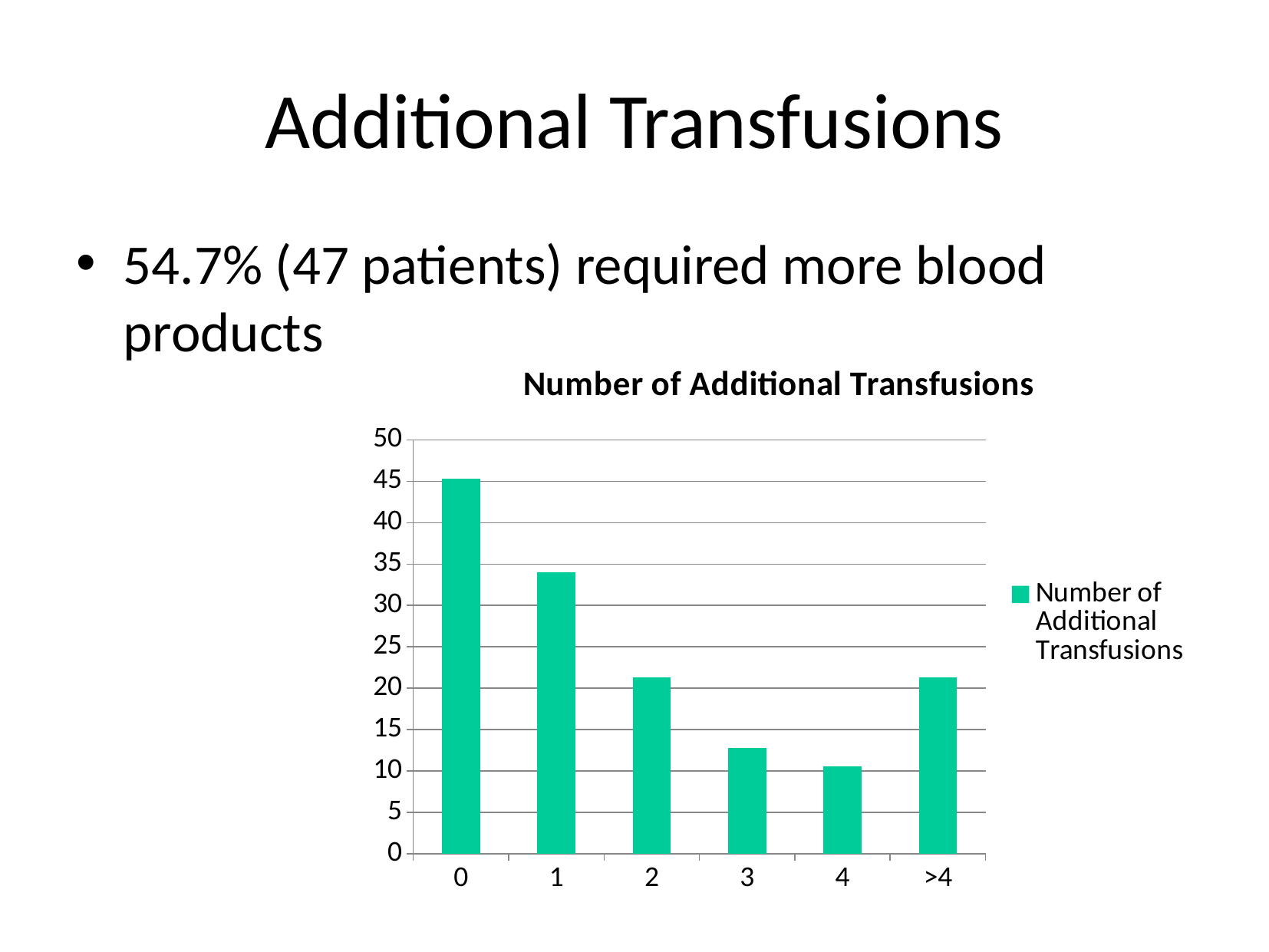
Is the value for category 1 greater or less than 30? greater Which category has the highest bar? 0 What type of chart is shown on the slide? bar chart How many categories are shown on the x axis of the chart? 6 Is the value for category 0 greater or less than 40? greater Is the value for category 3 greater or less than 15? less Which is larger, the value for category 1 or the value for category 3? 1 How many series does the legend list? 1 Which category has the lowest bar? 4 Do the values rise or fall from category 0 to category 4? fall What is the title of the chart? Number of Additional Transfusions